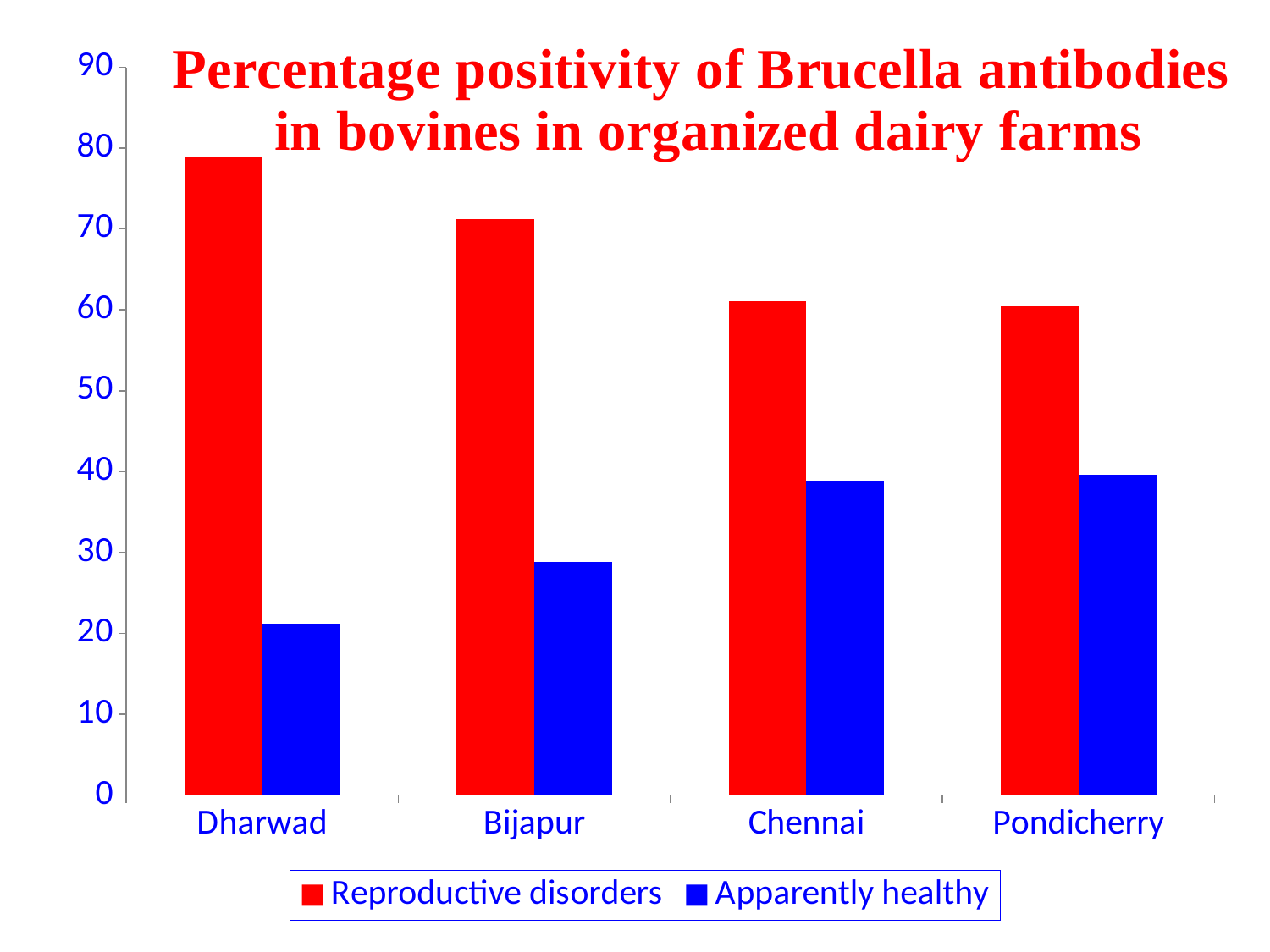
Is the value for Apparently healthy in Bijapur greater or less than 30? less Is the value for Reproductive disorders in Dharwad greater or less than 70? greater Do the Reproductive disorders values rise or fall from Dharwad to Pondicherry? fall How many locations are shown on the x axis? 4 Which colour represents the Apparently healthy series? blue Which is larger: Reproductive disorders in Bijapur or Reproductive disorders in Chennai? Reproductive disorders in Bijapur Which location has the highest value for Reproductive disorders? Dharwad Which location has the lowest value for Apparently healthy? Dharwad What kind of chart is shown on the slide? bar chart How many series does the legend list? 2 Is the value for Apparently healthy in Pondicherry greater or less than 50? less